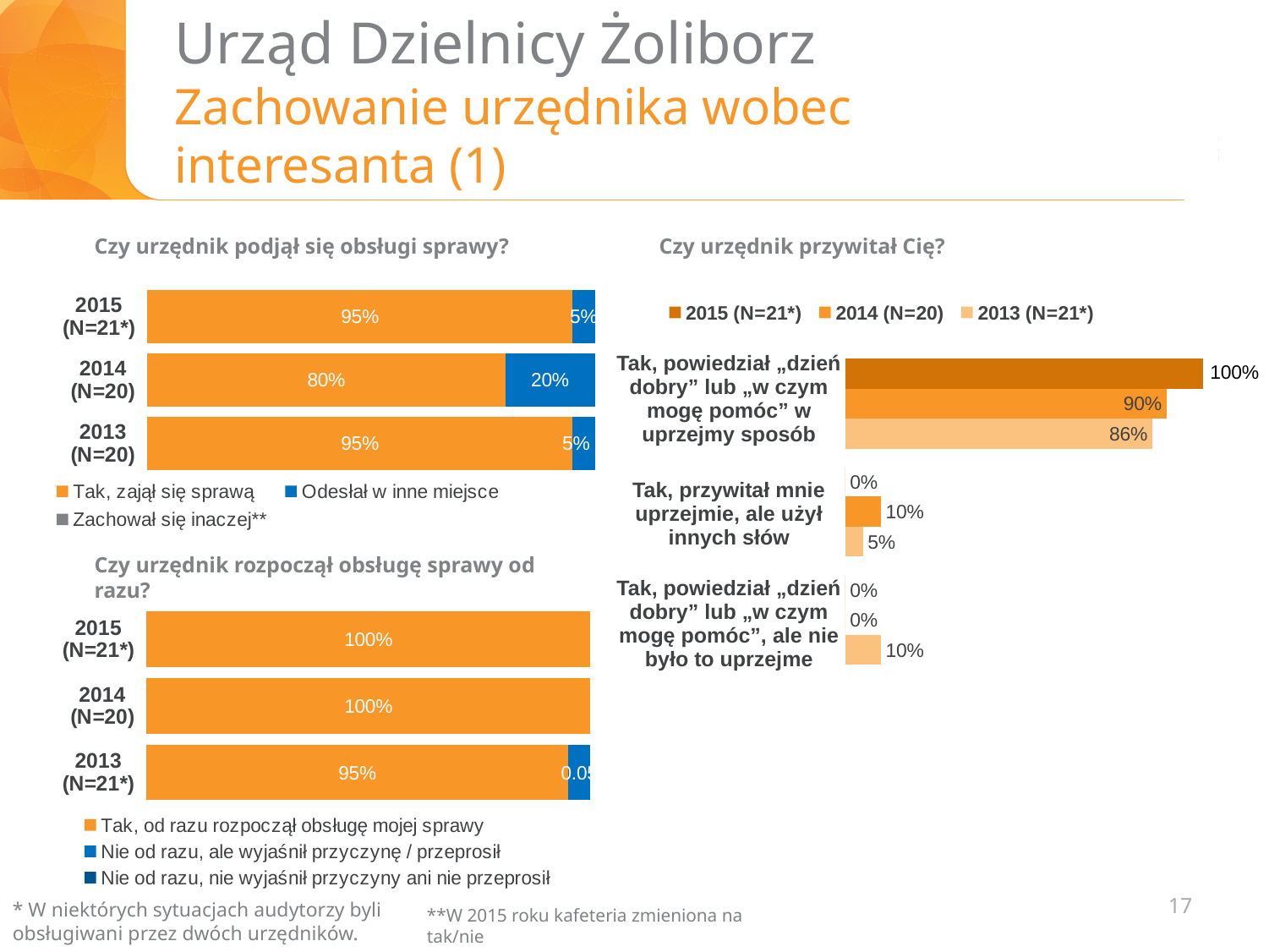
What type of chart is 'Czy urzędnik podjął się obsługi sprawy?'? Stacked bar chart In the chart 'Czy urzędnik podjął się obsługi sprawy?', which year has the lowest share for 'Tak, zajął się sprawą'? 2014 (N=20) In the chart 'Czy urzędnik przywitał Cię?', what is the 2014 (N=20) value for 'Tak, przywitał mnie uprzejmie, ale użył innych słów'? 10% In the chart 'Czy urzędnik przywitał Cię?', what is the 2013 (N=21*) value for 'Tak, powiedział „dzień dobry” lub „w czym mogę pomóc” w uprzejmy sposób'? 86% In the chart 'Czy urzędnik podjął się obsługi sprawy?', what is the difference between the 'Odesłał w inne miejsce' share in 2014 (N=20) and in 2015 (N=21*)? 15% In the chart 'Czy urzędnik rozpoczął obsługę sprawy od razu?', what is the 'Tak, od razu rozpoczął obsługę mojej sprawy' share for 2013 (N=21*)? 95% In the chart 'Czy urzędnik rozpoczął obsługę sprawy od razu?', what is the value for 2015 (N=21*)? 100% In the chart 'Czy urzędnik przywitał Cię?', which series has the highest value for 'Tak, powiedział „dzień dobry” lub „w czym mogę pomóc” w uprzejmy sposób'? 2015 (N=21*) How many series does the legend of the chart 'Czy urzędnik przywitał Cię?' list? 3 How many legend entries does the chart 'Czy urzędnik rozpoczął obsługę sprawy od razu?' list? 3 In the chart 'Czy urzędnik podjął się obsługi sprawy?', what share of the 2014 (N=20) bar is 'Tak, zajął się sprawą'? 80% In the chart 'Czy urzędnik podjął się obsługi sprawy?', what share of the 2014 (N=20) bar is 'Odesłał w inne miejsce'? 20%